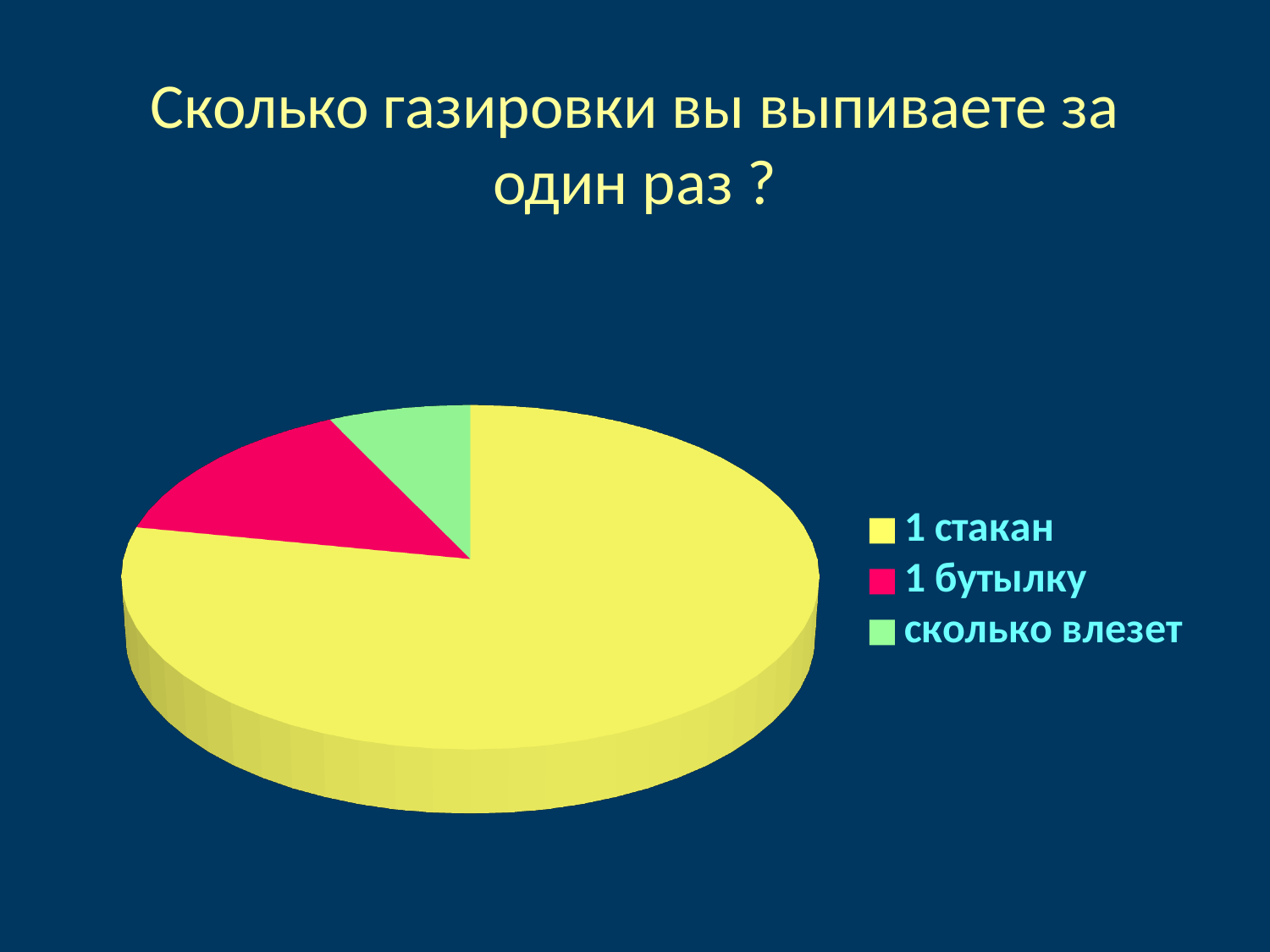
What kind of chart is shown on the slide? Pie chart Which slice is larger: "1 бутылку" or "сколько влезет"? 1 бутылку Which category is shown in yellow? 1 стакан Which category has the largest share of the pie? 1 стакан How many categories does the pie chart show? 3 Which category has the smallest share of the pie? сколько влезет Which slice is larger: "1 стакан" or "1 бутылку"? 1 стакан What is the title of the chart on the slide? Сколько газировки вы выпиваете за один раз ? What colour is the slice for "1 бутылку"? Red